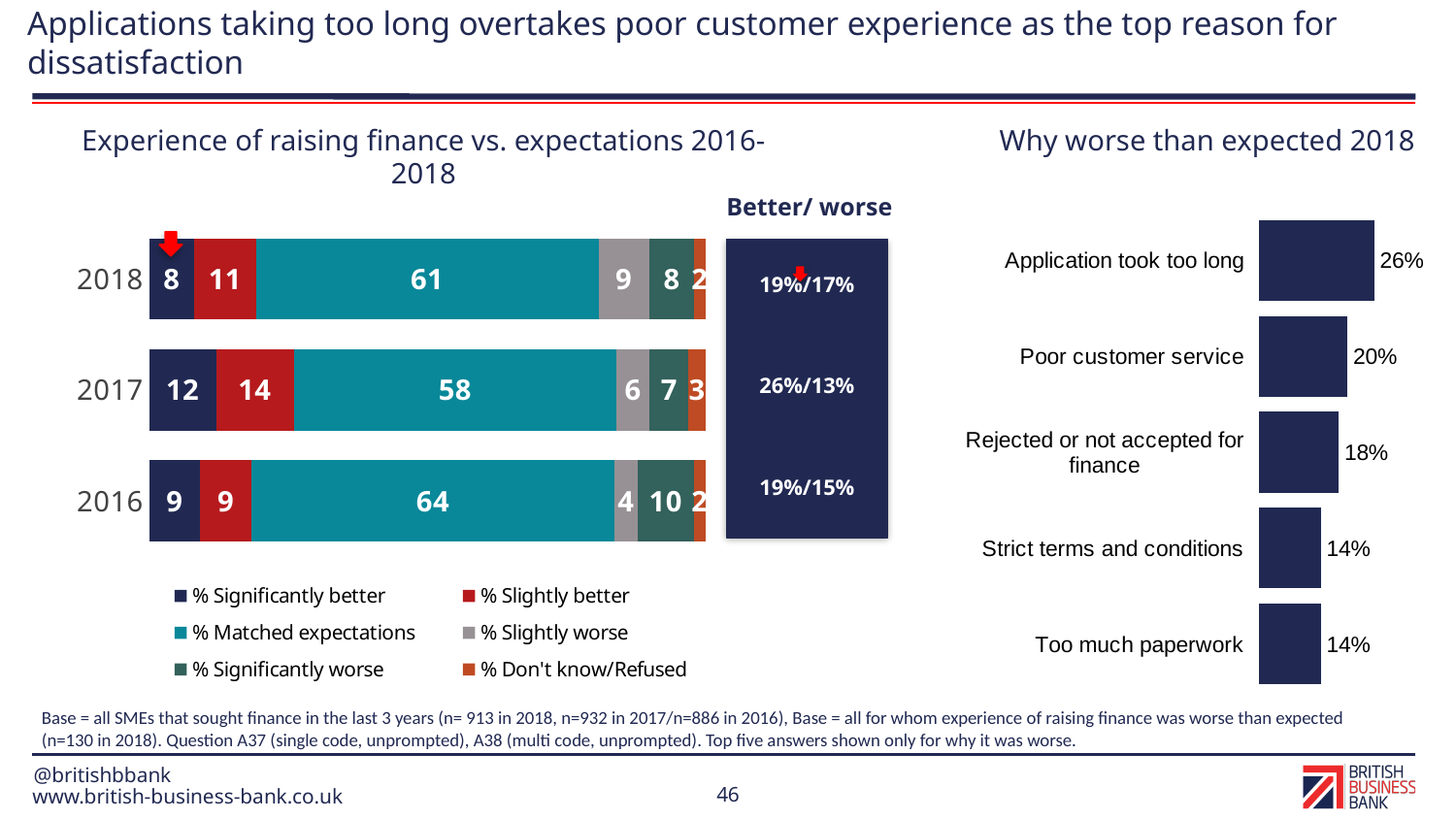
In the 'Experience of raising finance vs. expectations 2016-2018' chart, what is the value for '% Matched expectations' in 2018? 61 In the 'Experience of raising finance vs. expectations 2016-2018' chart, how many series does the legend list? 6 In the 'Experience of raising finance vs. expectations 2016-2018' chart, what is the value for '% Significantly worse' in 2016? 10 In the 'Experience of raising finance vs. expectations 2016-2018' chart, what is the difference between the '% Significantly better' values for 2017 and 2018? 4 In the 'Experience of raising finance vs. expectations 2016-2018' chart, which year has the highest value for '% Matched expectations'? 2016 In the 'Experience of raising finance vs. expectations 2016-2018' chart, what is the value for '% Slightly better' in 2017? 14 In the 'Experience of raising finance vs. expectations 2016-2018' chart, which colour represents '% Matched expectations'? Teal In the 'Why worse than expected 2018' chart, what is the value for 'Poor customer service'? 20% In the 'Why worse than expected 2018' chart, which category has the highest value? Application took too long In the 'Why worse than expected 2018' chart, what is the difference between 'Application took too long' and 'Rejected or not accepted for finance'? 8% In the 'Why worse than expected 2018' chart, how many categories are shown? 5 What kind of chart is the 'Why worse than expected 2018' chart? Bar chart